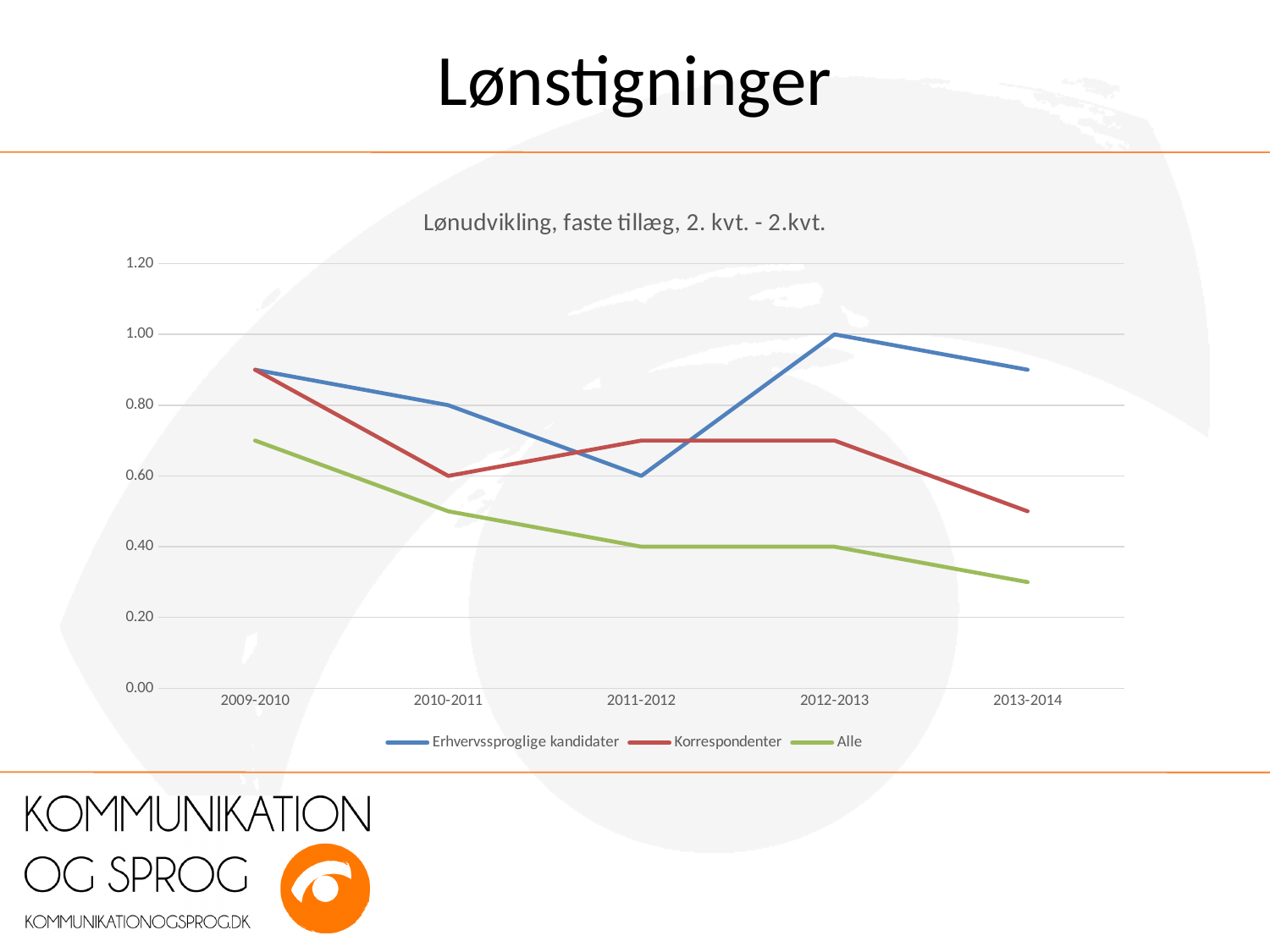
Which series is higher in 2013-2014, Erhvervssproglige kandidater or Alle? Erhvervssproglige kandidater How many periods are shown on the x axis? 5 In which period is the value for Alle lowest? 2013-2014 What is the value for Alle in 2011-2012? 0.40 What is the value for Korrespondenter in 2010-2011? 0.60 Is the value for Korrespondenter in 2013-2014 greater or less than 0.60? less How many series does the legend list? 3 What is the value for Erhvervssproglige kandidater in 2010-2011? 0.80 What kind of chart is shown on the slide? Line chart What is the value for Erhvervssproglige kandidater in 2012-2013? 1.00 In which period does Erhvervssproglige kandidater reach its highest value? 2012-2013 What is the title of the chart? Lønudvikling, faste tillæg, 2. kvt. - 2.kvt.